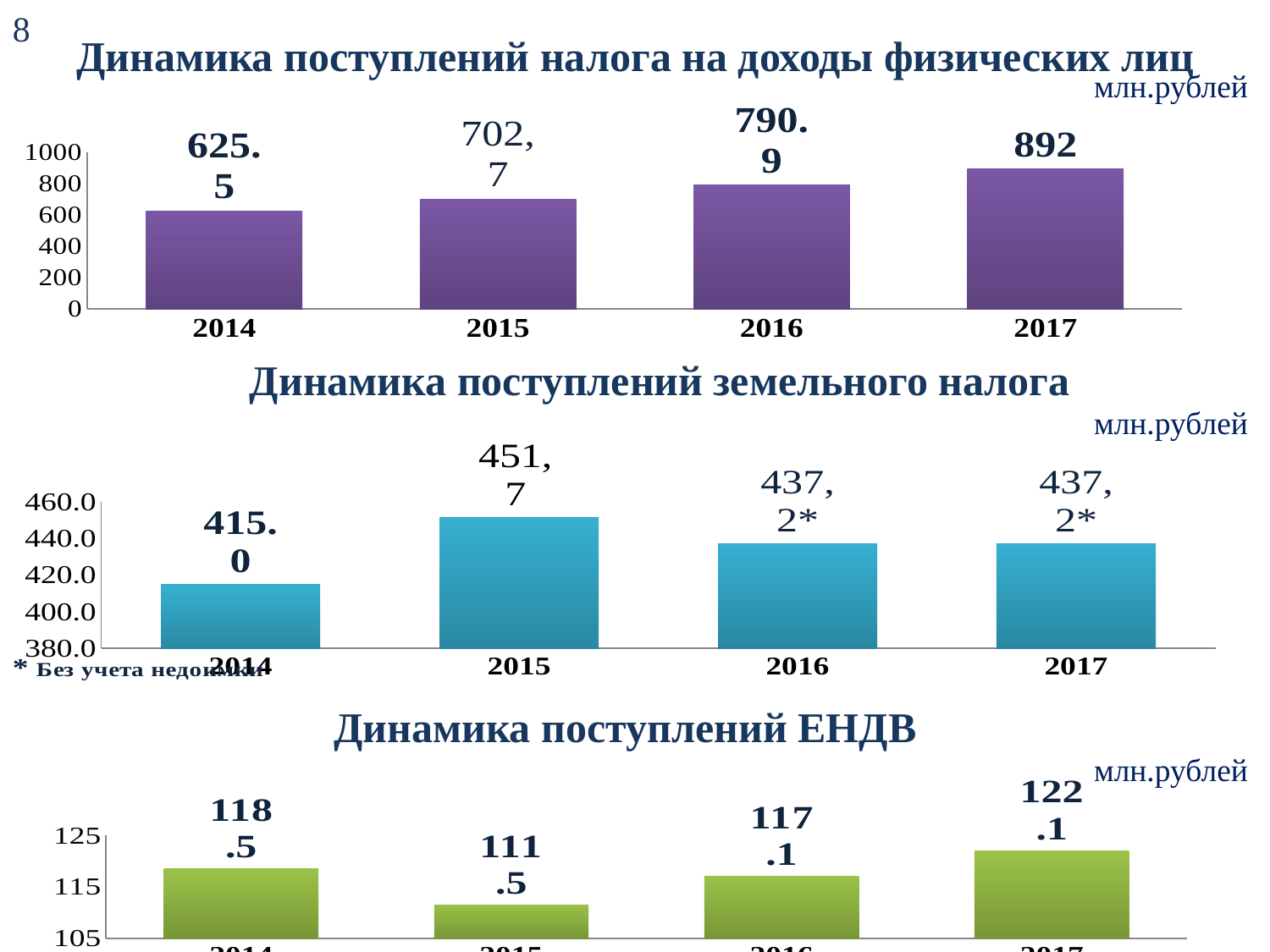
In the chart 'Динамика поступлений земельного налога', what is the value for 2015? 451,7 In the chart 'Динамика поступлений налога на доходы физических лиц', which year has the highest value? 2017 In the chart 'Динамика поступлений налога на доходы физических лиц', what is the value for 2017? 892 In the chart 'Динамика поступлений ЕНДВ', what is the value for 2015? 111.5 In the chart 'Динамика поступлений налога на доходы физических лиц', what is the difference between the 2017 value and the 2014 value? 266.5 In the chart 'Динамика поступлений земельного налога', which year has the highest value? 2015 What unit is indicated for the values in the chart 'Динамика поступлений ЕНДВ'? млн.рублей How many years are shown in the chart 'Динамика поступлений земельного налога'? 4 In the chart 'Динамика поступлений ЕНДВ', which year has the lowest value? 2015 What kind of chart is 'Динамика поступлений ЕНДВ'? bar chart In the chart 'Динамика поступлений налога на доходы физических лиц', do the values rise or fall from 2014 to 2017? rise In the chart 'Динамика поступлений земельного налога', which year has the lowest value? 2014